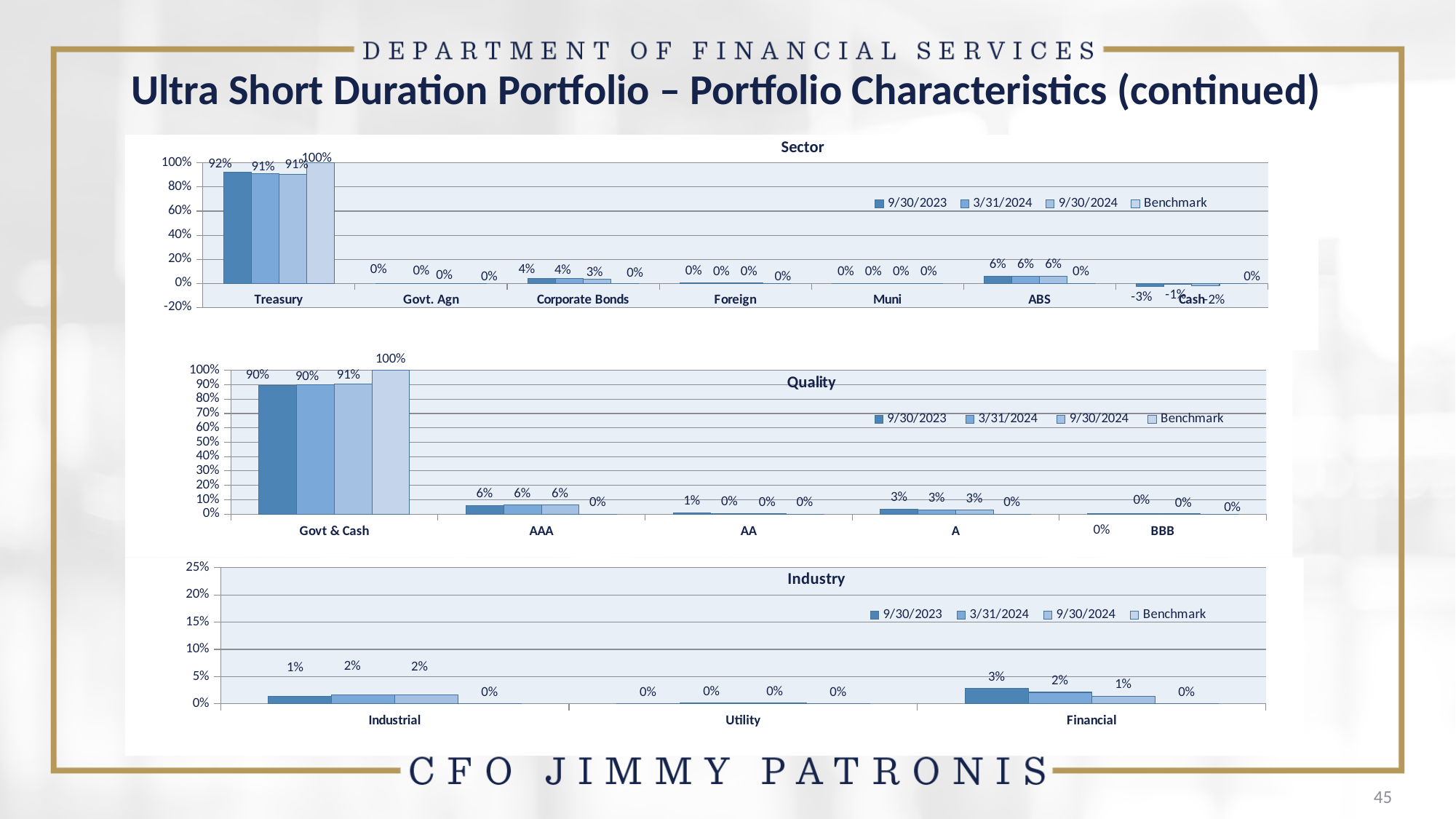
In the Sector chart, how many categories are shown on the x axis? 7 What kind of chart is the Quality chart? Bar chart How many series does the legend of the Industry chart list? 4 In the Quality chart, what is the 9/30/2023 value for AA? 1% In the Quality chart, which category has the highest 9/30/2023 value? Govt & Cash In the Sector chart, what is the 9/30/2023 value for Cash? -3% In the Sector chart, what is the 9/30/2023 value for Treasury? 92% In the Quality chart, what is the 9/30/2024 value for Govt & Cash? 91% In the Industry chart, which is larger for Industrial: the 9/30/2023 value or the 3/31/2024 value? 3/31/2024 In the Industry chart, what is the 9/30/2023 value for Financial? 3% In the Sector chart, what is the difference between the 9/30/2023 and 9/30/2024 values for Corporate Bonds? 1% In the Sector chart, what is the Benchmark value for Treasury? 100%